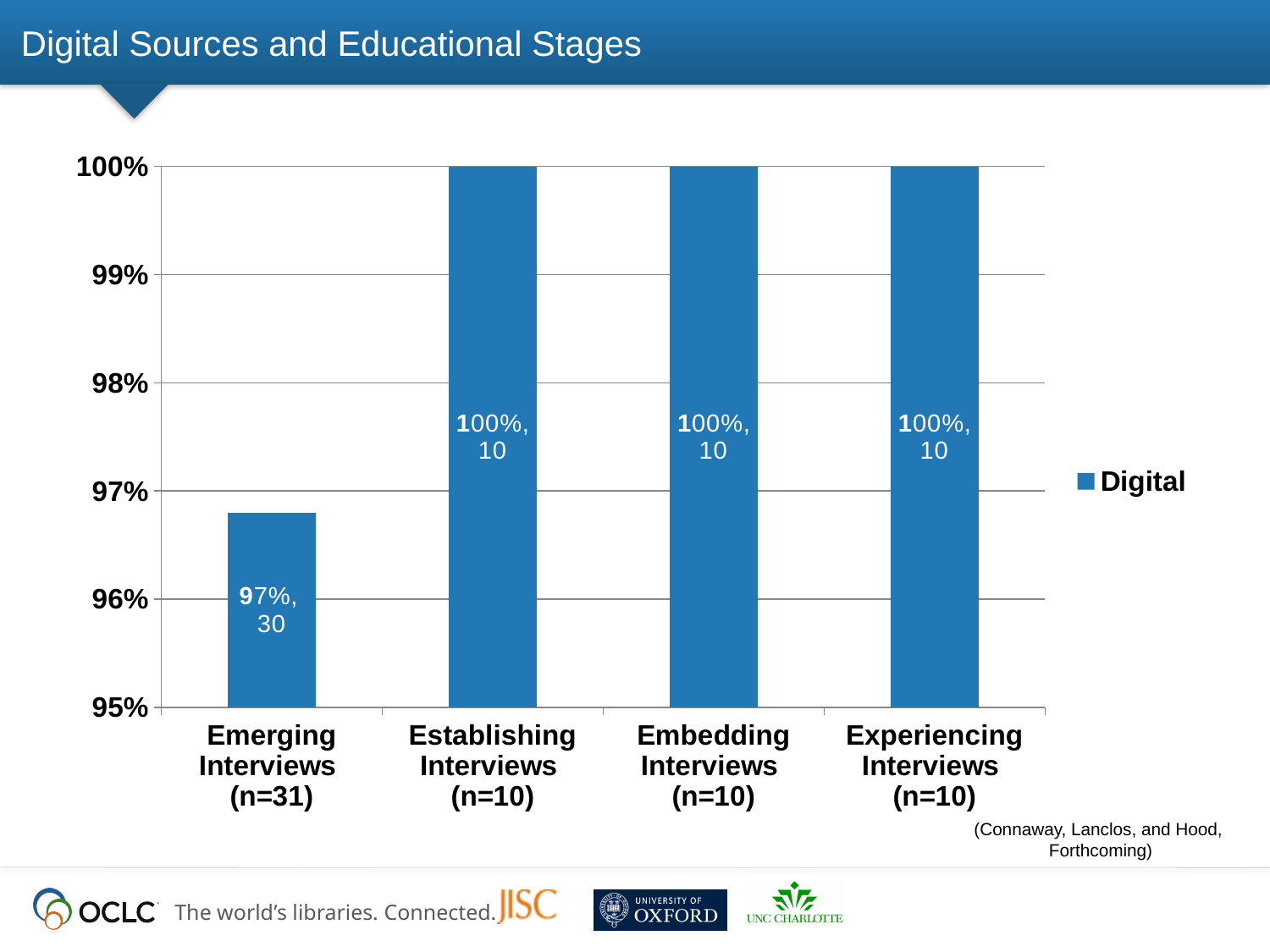
Which is larger, the Digital value for Establishing Interviews (n=10) or Emerging Interviews (n=31)? Establishing Interviews (n=10) What is the Digital value for Establishing Interviews (n=10)? 100% Is the value for Emerging Interviews (n=31) greater or less than 96%? greater What kind of chart is shown on the slide? bar chart Which category has the lowest Digital value? Emerging Interviews (n=31) What count is shown in the data label for Emerging Interviews (n=31)? 30 What count is shown in the data label for Embedding Interviews (n=10)? 10 What is the name of the series shown in the legend? Digital How many series does the legend list? 1 What is the Digital value for Emerging Interviews (n=31)? 97% How many categories are shown on the x axis? 4 What is the difference between the Digital value for Experiencing Interviews (n=10) and Emerging Interviews (n=31)? 3%